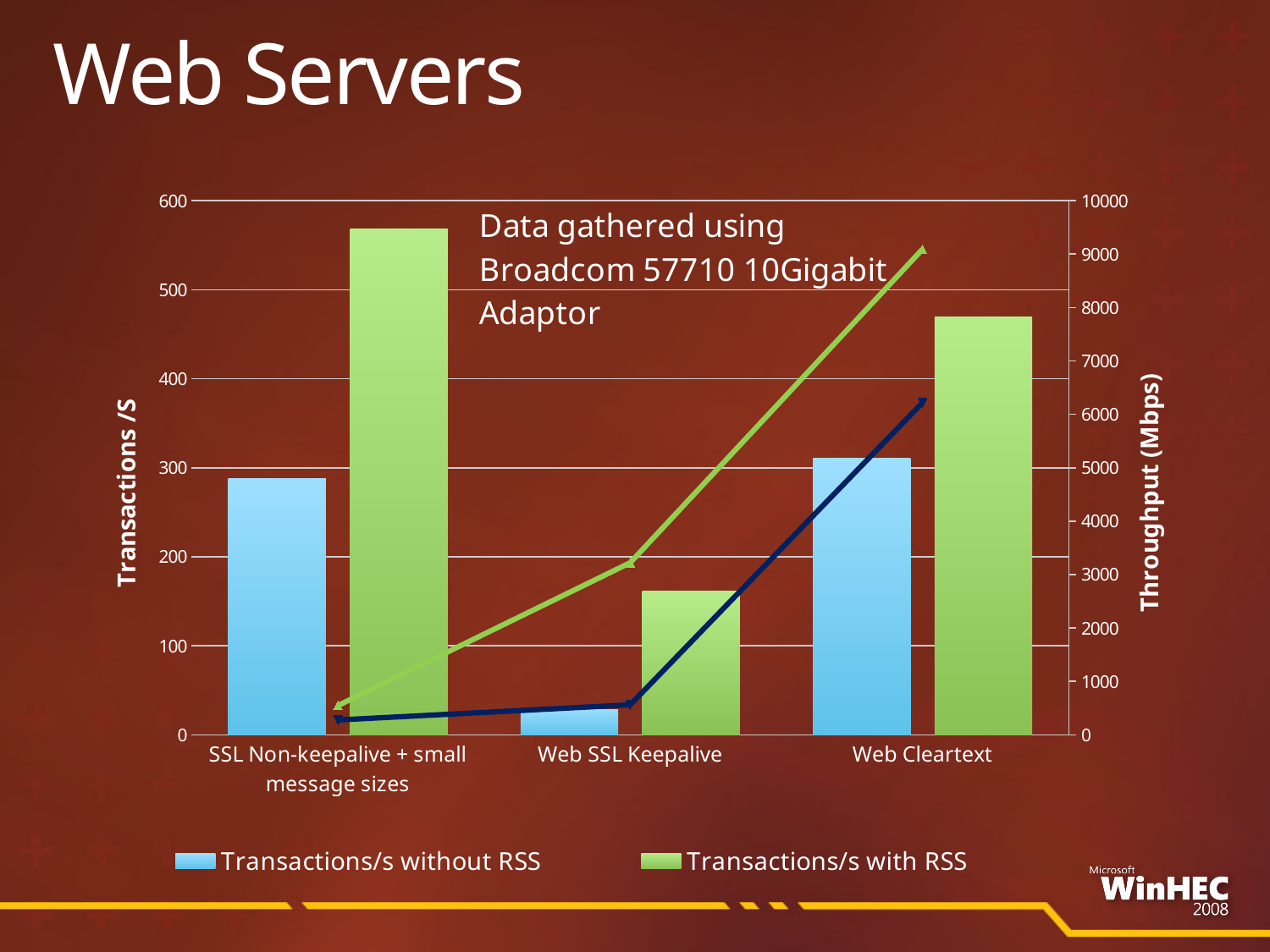
Is the value for Transactions/s with RSS for Web SSL Keepalive greater or less than 200? less How many categories are shown on the x axis? 3 What is the title of the right-hand vertical axis? Throughput (Mbps) For Web Cleartext, which is larger: Transactions/s with RSS or Transactions/s without RSS? Transactions/s with RSS Is the value for Transactions/s without RSS for Web Cleartext greater or less than 200? greater Which category has the highest value for Transactions/s with RSS? SSL Non-keepalive + small message sizes What kind of chart is shown on the slide? bar chart with line series Is the value for Transactions/s without RSS for Web SSL Keepalive greater or less than 100? less Which category has the lowest value for Transactions/s without RSS? Web SSL Keepalive How many series does the legend list? 2 For Transactions/s with RSS, which is larger: SSL Non-keepalive + small message sizes or Web Cleartext? SSL Non-keepalive + small message sizes